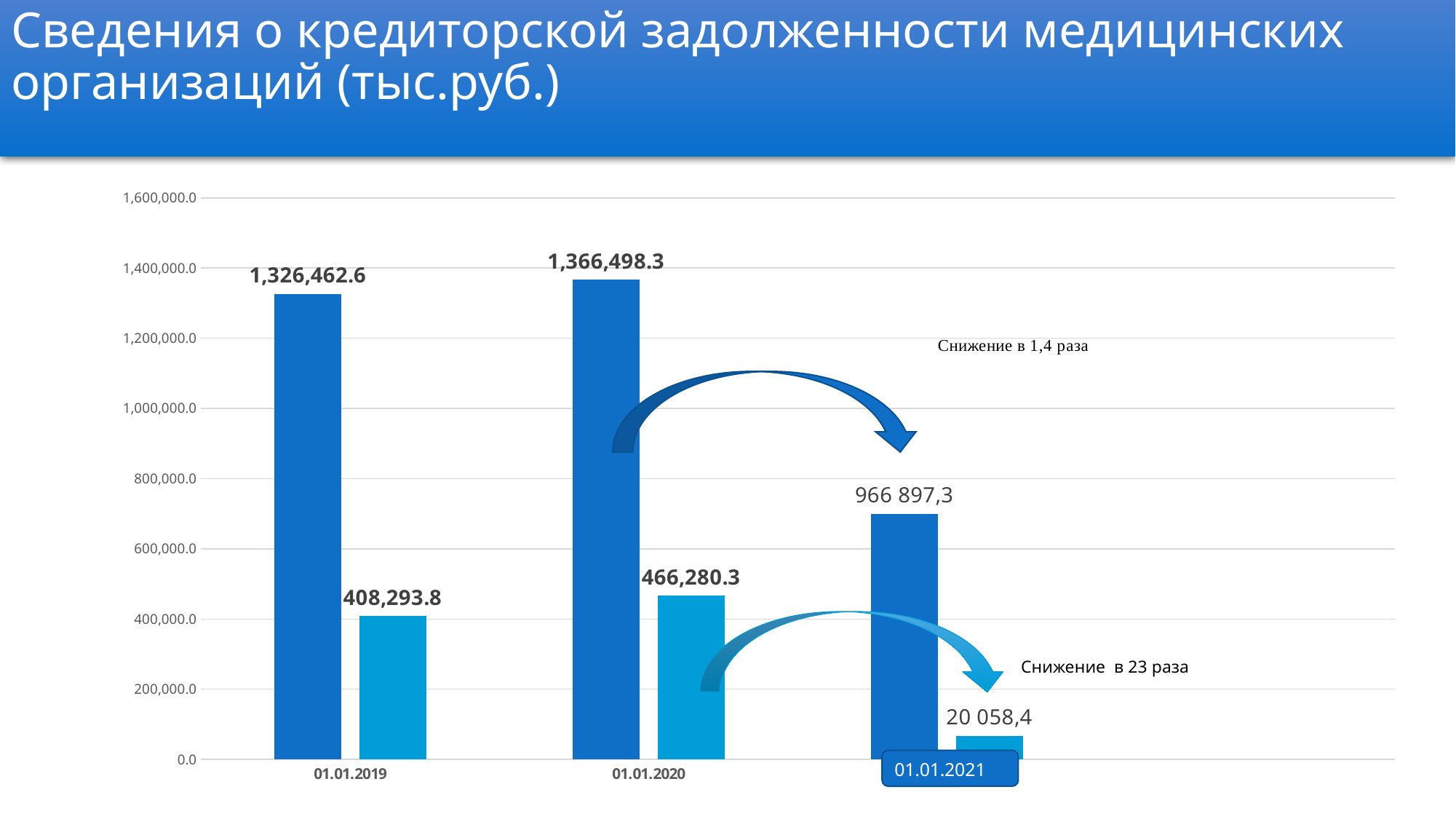
What is the value of the light blue bar for 01.01.2020? 466,280.3 Which is larger: the light blue bar for 01.01.2019 or the light blue bar for 01.01.2020? 01.01.2020 What is the value of the dark blue bar for 01.01.2019? 1,326,462.6 What is the difference between the light blue bars for 01.01.2020 (466,280.3) and 01.01.2019 (408,293.8)? 57,986.5 What type of chart is shown on the slide? bar chart On which date is the light blue bar the lowest? 01.01.2021 What is the value of the dark blue bar for 01.01.2021? 966 897,3 On which date is the dark blue bar the highest? 01.01.2020 How many dates (categories) are shown on the x axis of the chart? 3 What is the value of the light blue bar for 01.01.2021? 20 058,4 Is the dark blue bar for 01.01.2021 greater or less than 1,000,000.0? less What is the title of the chart on the slide? Сведения о кредиторской задолженности медицинских организаций (тыс.руб.)